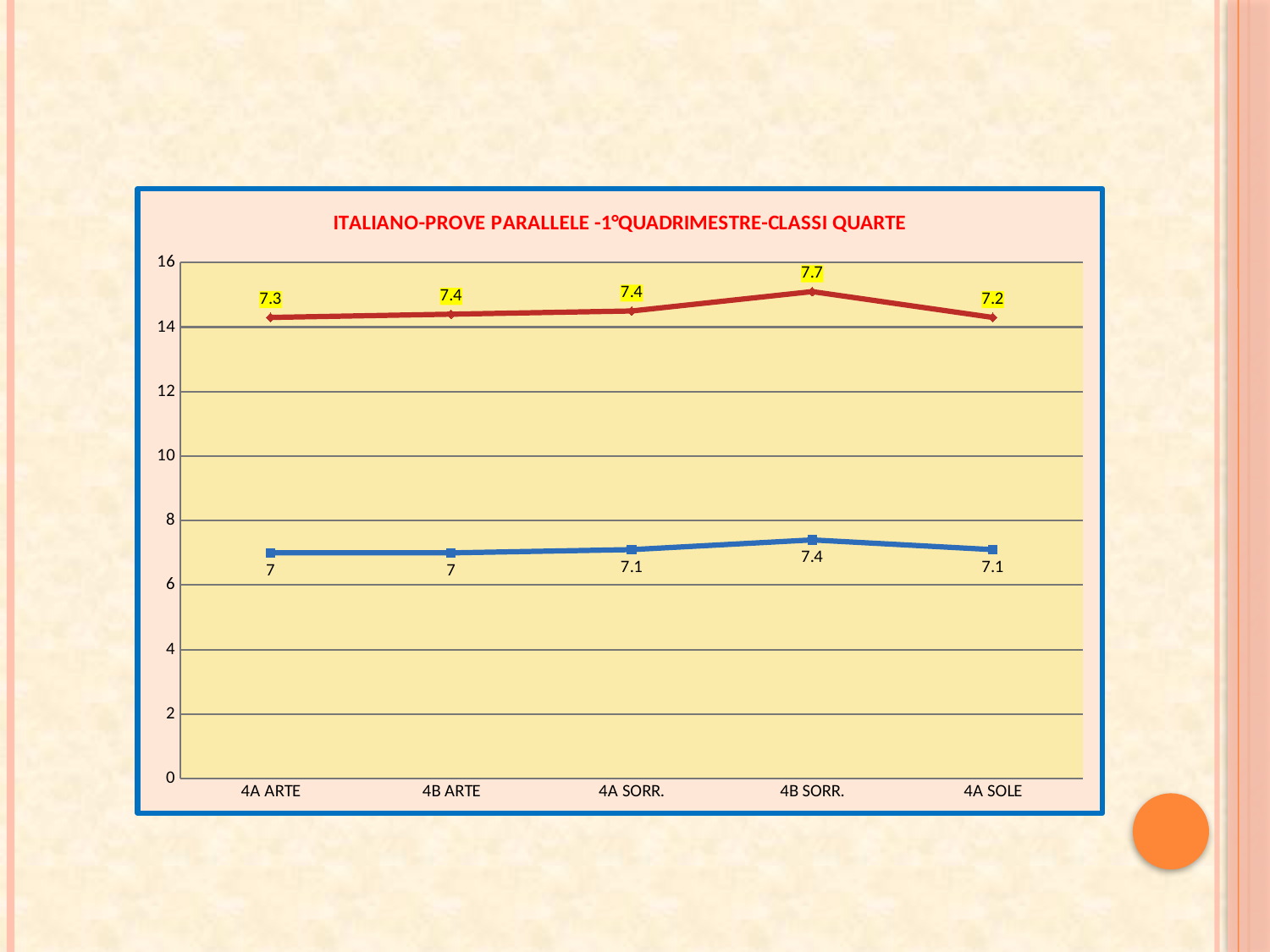
For the blue line, which category has the highest data label? 4B SORR. What is the difference between the red line's data labels at 4B SORR. and 4A SOLE? 0.5 What kind of chart is shown on the slide? line chart What is the data label for the blue line at 4A SORR.? 7.1 For the red line, which category has the lowest data label? 4A SOLE For the blue line, which is larger: the data label at 4B SORR. or at 4A SOLE? 4B SORR. What is the title of the chart? ITALIANO-PROVE PARALLELE -1°QUADRIMESTRE-CLASSI QUARTE What is the data label for the red line at 4A ARTE? 7.3 For the red line, which category has the highest data label? 4B SORR. What is the data label for the blue line at 4B SORR.? 7.4 How many categories are shown on the x axis? 5 What is the data label for the red line at 4A SOLE? 7.2